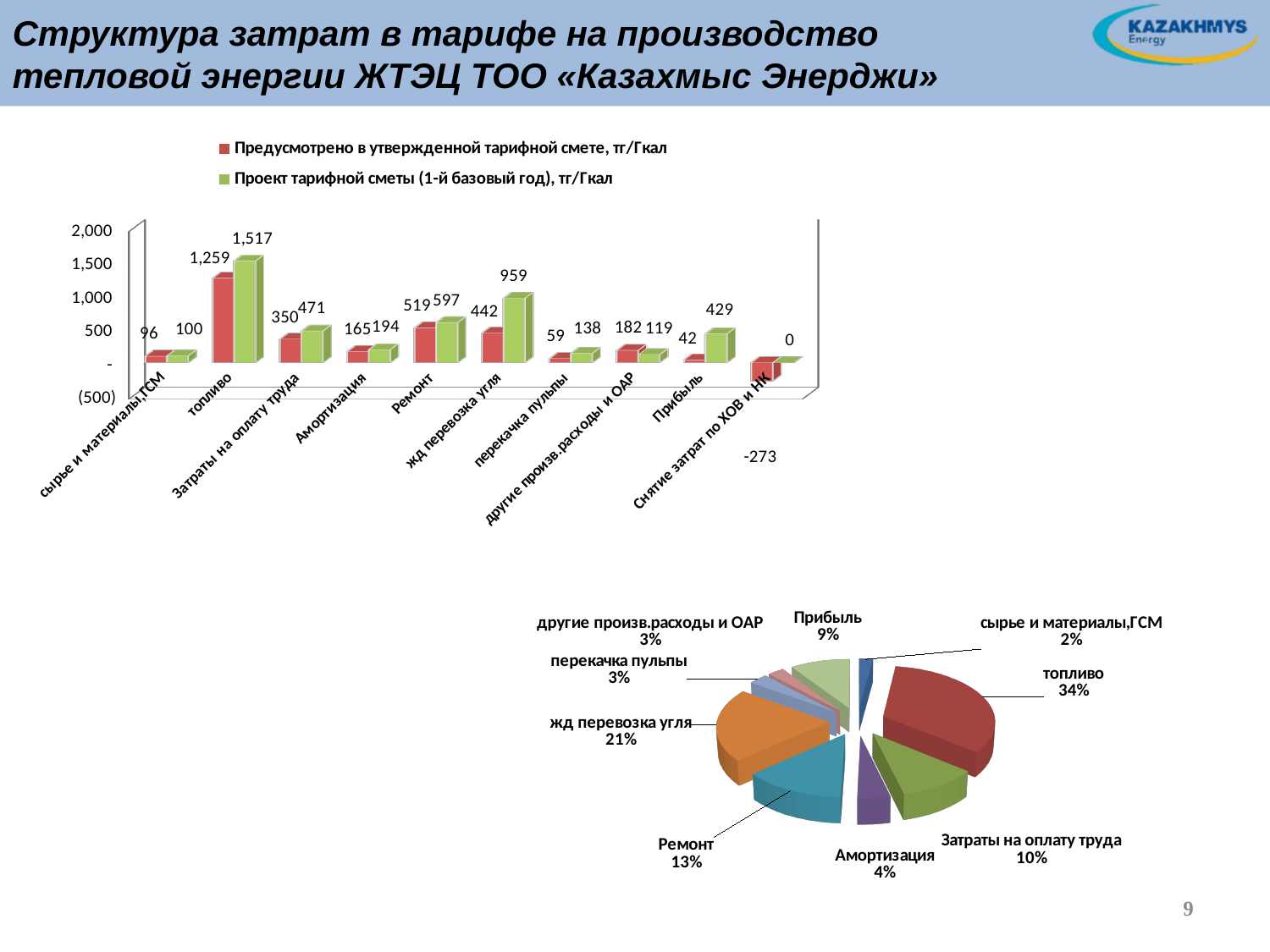
In the pie chart, what share does 'жд перевозка угля' have? 21% In the pie chart, which slice is the largest? топливо In the bar chart, which category has the lowest value for 'Предусмотрено в утвержденной тарифной смете, тг/Гкал'? Снятие затрат по ХОВ и НК How many categories are shown on the x axis of the bar chart? 10 In the bar chart, what is the difference between the two series for 'Прибыль'? 387 How many series does the legend of the bar chart list? 2 In the bar chart, what is the value of 'Проект тарифной сметы (1-й базовый год), тг/Гкал' for 'топливо'? 1,517 In the bar chart, what is the value of 'Предусмотрено в утвержденной тарифной смете, тг/Гкал' for 'Снятие затрат по ХОВ и НК'? -273 In the bar chart, what is the value of 'Предусмотрено в утвержденной тарифной смете, тг/Гкал' for 'жд перевозка угля'? 442 In the bar chart, for 'другие произв.расходы и ОАР', which series has the larger value? Предусмотрено в утвержденной тарифной смете, тг/Гкал In the bar chart, which category has the highest value for 'Проект тарифной сметы (1-й базовый год), тг/Гкал'? топливо How many slices does the pie chart have? 9